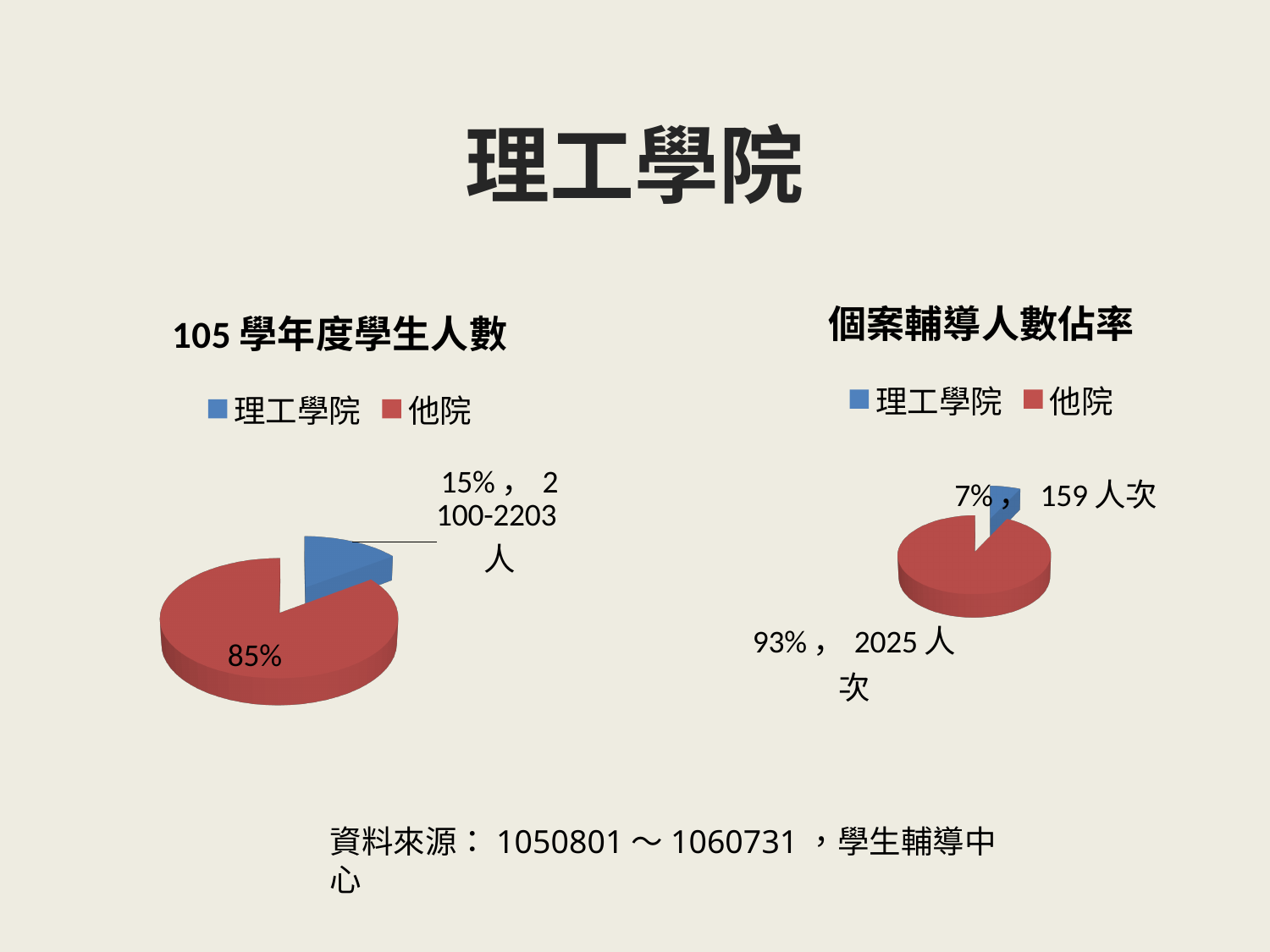
In the chart titled 個案輔導人數佔率, what is the difference in 人次 between 他院 and 理工學院? 1866 人次 In the chart titled 個案輔導人數佔率, how many 人次 are labelled for 理工學院? 159 人次 How many categories does the legend of the chart titled 個案輔導人數佔率 list? 2 In the chart titled 個案輔導人數佔率, which category has the largest slice? 他院 In the chart titled 個案輔導人數佔率, how many 人次 are labelled for 他院? 2025 人次 In the chart titled 105 學年度學生人數, what share of the pie does 他院 represent? 85% In the chart titled 個案輔導人數佔率, what share of the pie does 理工學院 represent? 7% What type of chart is the chart titled 105 學年度學生人數? Pie chart In the chart titled 105 學年度學生人數, what share of the pie does 理工學院 represent? 15% In the chart titled 105 學年度學生人數, which category has the smallest slice? 理工學院 In the chart titled 105 學年度學生人數, which colour represents 理工學院? Blue